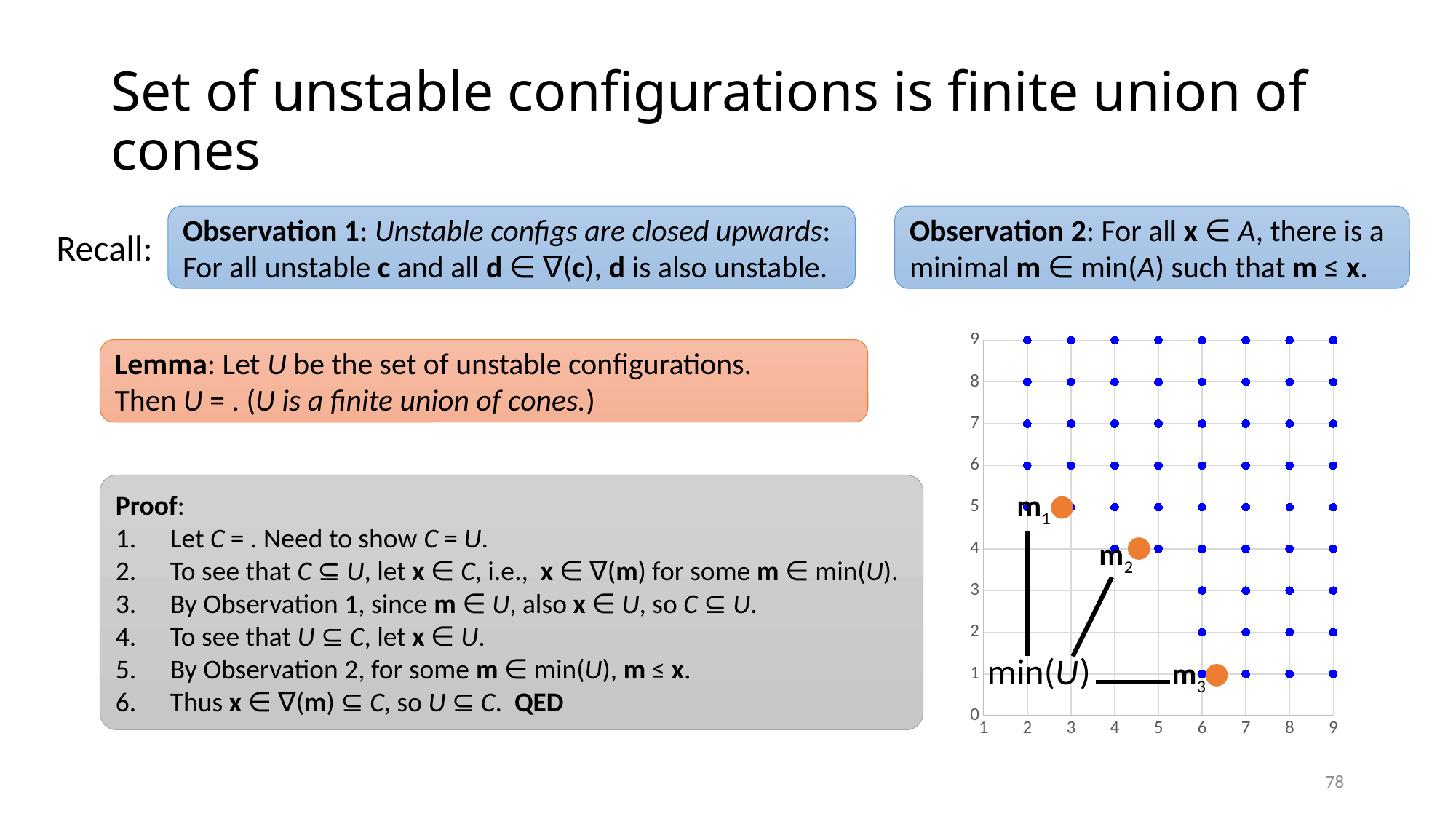
Which of the orange points, m1, m2 or m3, has the lowest y-value? m3 Which of the orange points, m1, m2 or m3, has the highest y-value? m1 Which has the larger y-value, m2 or m3? m2 How many orange (labelled) points are plotted on the chart? 3 Is the y-value of point m1 greater or less than 4? greater How many blue points are plotted in the top row of the chart (at y = 9)? 8 What kind of chart is shown on the right side of the slide? scatter chart What label is written next to the orange points on the chart? min(U) Is the y-value of point m3 greater or less than 2? less Which of the orange points, m1, m2 or m3, is furthest to the right on the x axis? m3 What is the highest tick value shown on the y axis of the chart? 9 Is the x-value of point m2 greater or less than 3? greater